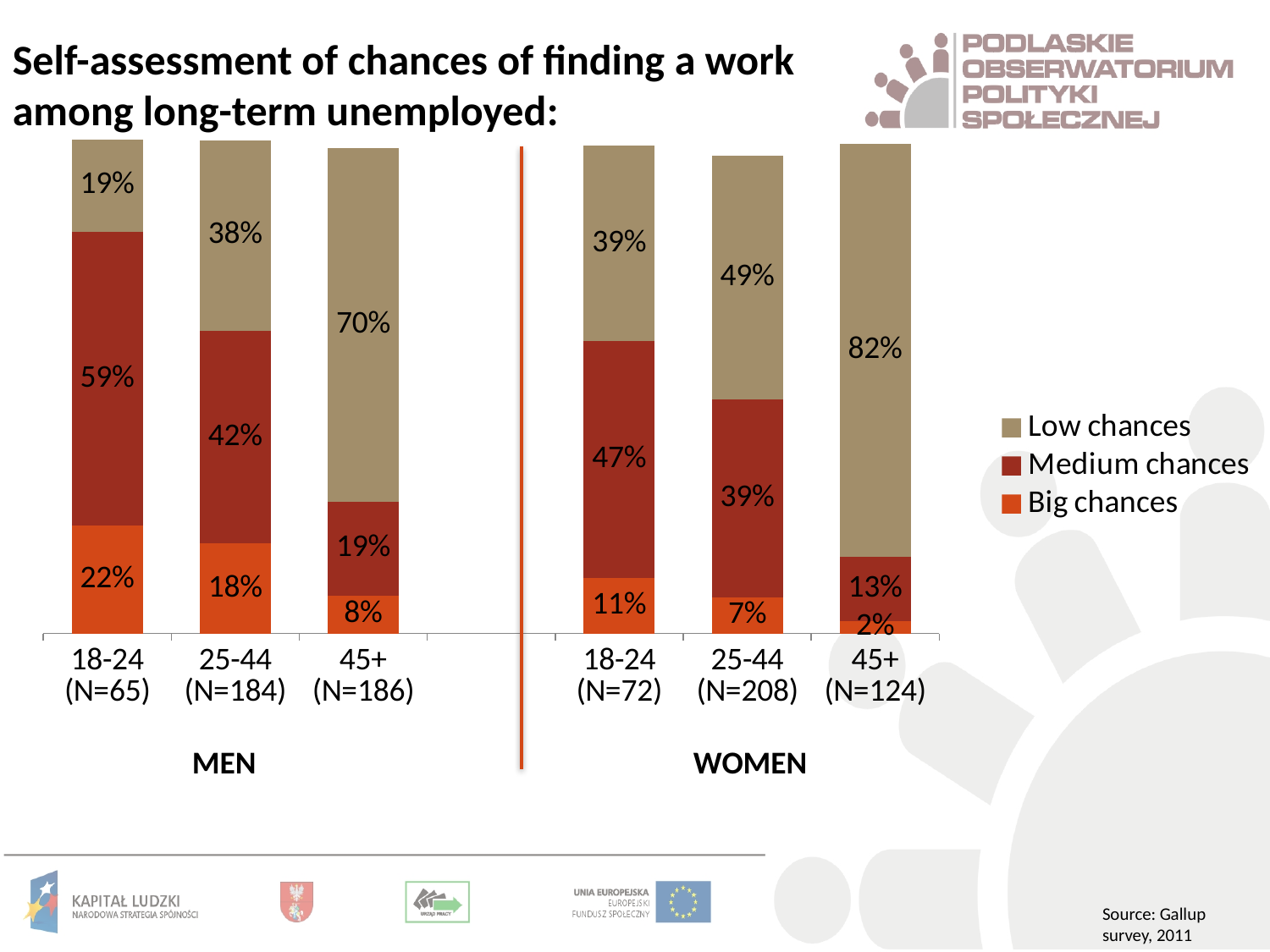
What is the Medium chances value for men aged 25-44 (N=184)? 42% Which group has the highest Low chances value? Women 45+ (N=124) What percentage of men aged 45+ (N=186) rated their chances of finding work as low? 70% Which series is shown in the tan/beige colour at the top of each bar? Low chances What type of chart is shown on the slide? Stacked bar chart Which group has the lowest Big chances value? Women 45+ (N=124) Which is larger: the Medium chances value for men aged 18-24 or for women aged 18-24? Men 18-24 (59%) What is the Big chances value for women aged 18-24 (N=72)? 11% How many series does the legend list? 3 What is the difference between the Low chances values for women aged 45+ and men aged 45+? 12 percentage points How many age groups (bars) are shown in the chart? 6 For women, how does the Low chances value change as the age group increases from 18-24 to 45+? It rises